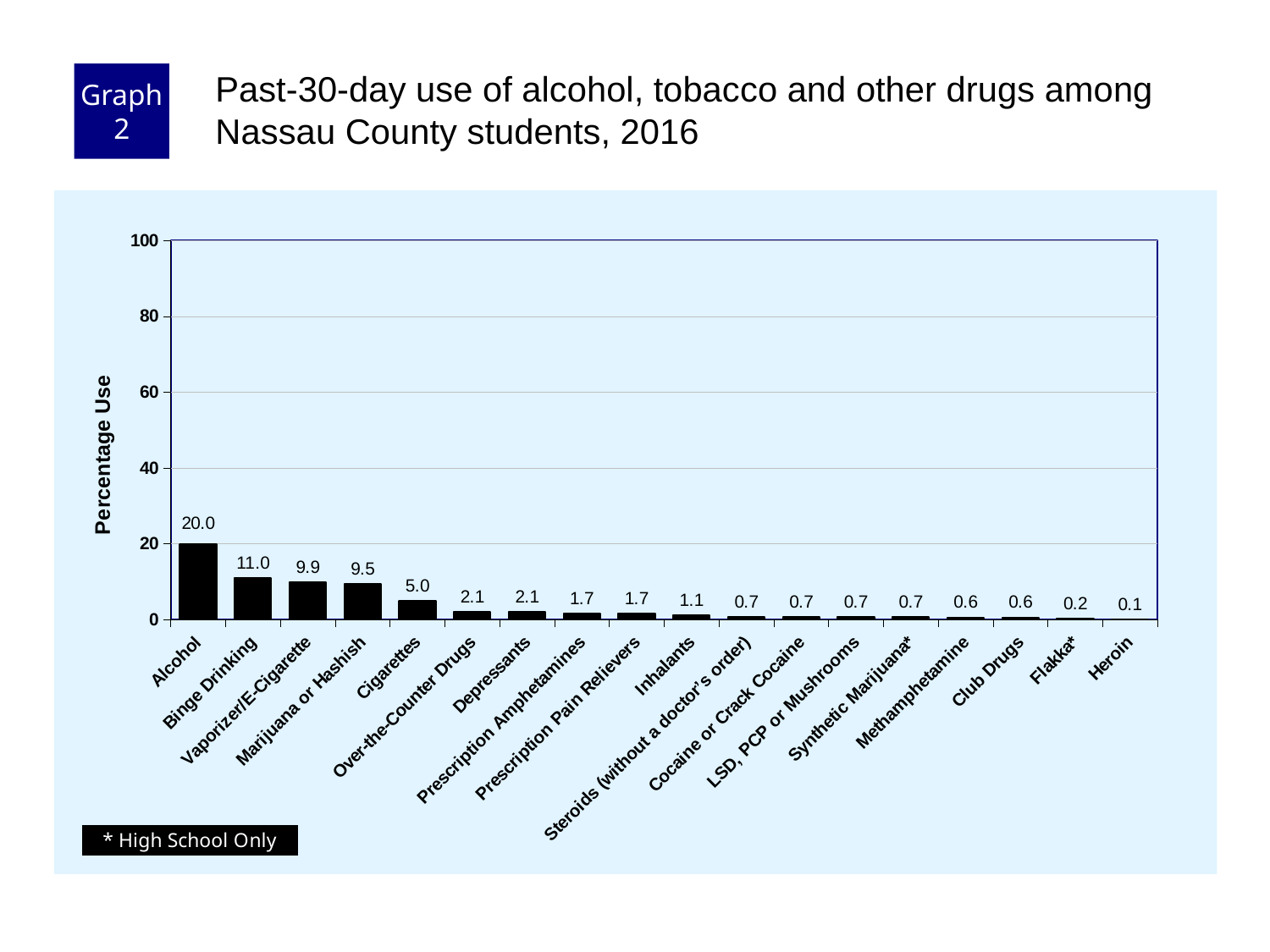
What is the past-30-day use percentage for Alcohol? 20.0 What is the value shown for Cigarettes? 5.0 Which category has the lowest percentage use? Heroin What is the value shown for Heroin? 0.1 What is the value shown for Inhalants? 1.1 What is the difference between the values for Vaporizer/E-Cigarette and Marijuana or Hashish? 0.4 Is the value for Binge Drinking greater or less than 20? less What type of chart is shown on the slide? Bar chart Which category has the highest percentage use? Alcohol Which is larger, the value for Cigarettes or the value for Over-the-Counter Drugs? Cigarettes How many categories are shown on the x axis? 18 What is the difference between the values for Alcohol and Binge Drinking? 9.0